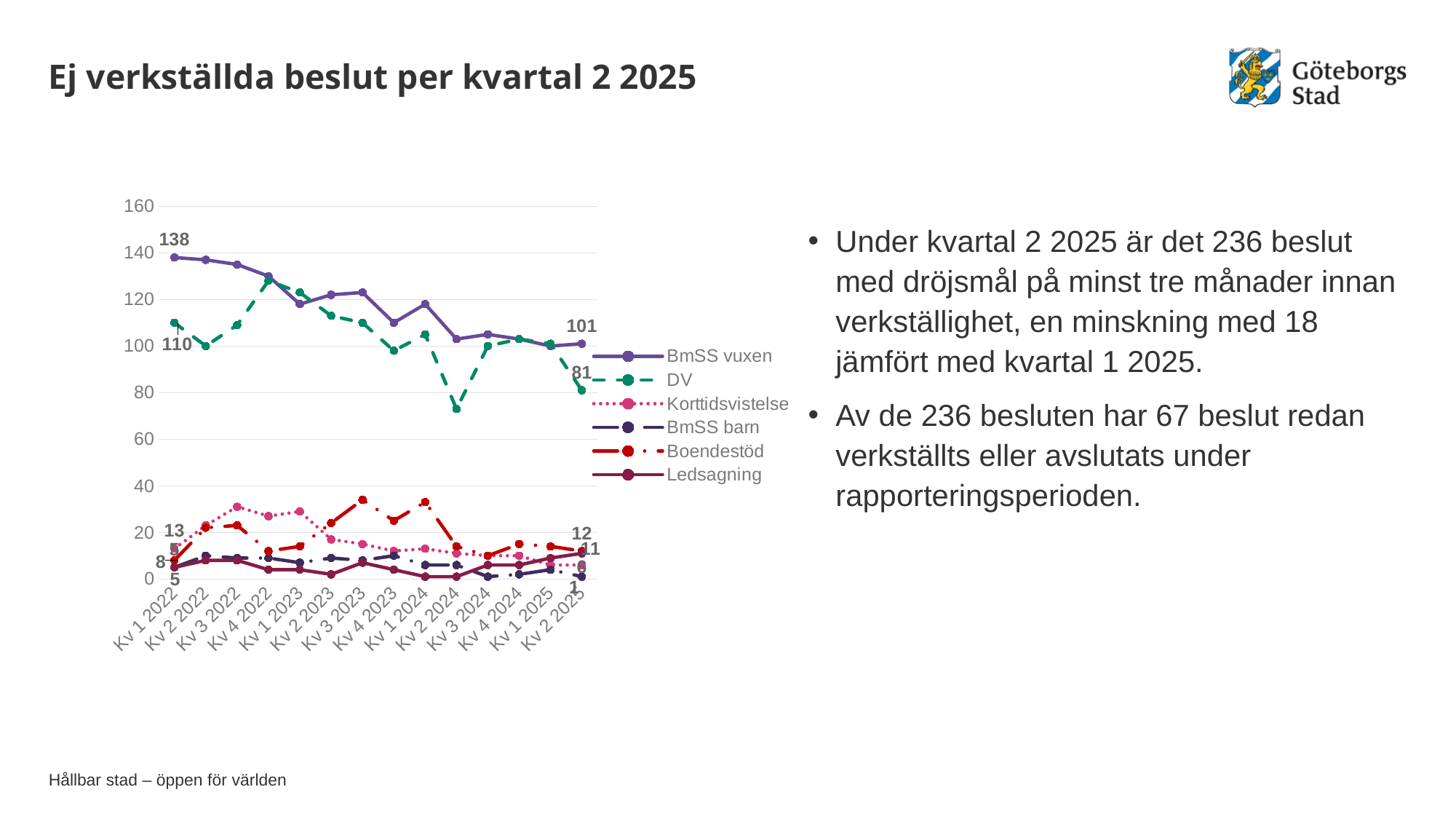
Does the BmSS vuxen line generally rise or fall from Kv 1 2022 to Kv 2 2025? fall What is the value for DV in Kv 1 2022? 110 What is the value for BmSS vuxen in Kv 2 2025? 101 What is the value for Korttidsvistelse in Kv 1 2022? 13 What is the value for DV in Kv 2 2025? 81 Which series has the higher value in Kv 2 2025, BmSS vuxen or DV? BmSS vuxen By how much did the BmSS vuxen value fall from Kv 1 2022 to Kv 2 2025? 37 What is the value for BmSS vuxen in Kv 1 2022? 138 What kind of chart is shown on the slide? line chart Is the value for DV in Kv 2 2024 greater or less than 80? less How many series does the chart legend list? 6 How many quarters are shown along the x axis of the chart? 14